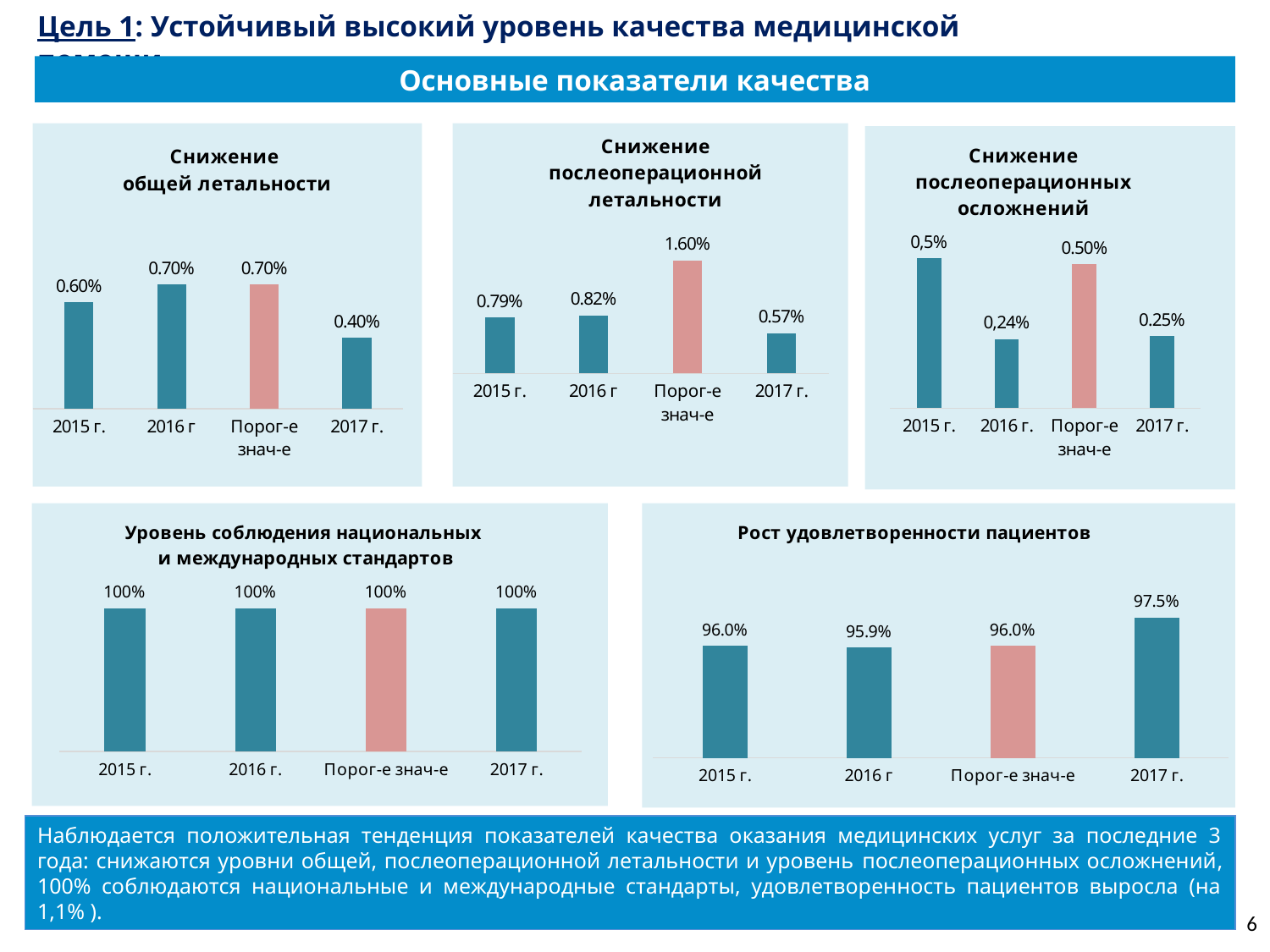
In the chart titled "Снижение послеоперационной летальности", what is the difference between the Порог-е знач-е value and the 2017 г. value? 1.03% In the chart titled "Снижение послеоперационных осложнений", which category has the lowest value? 2016 г. In the chart titled "Рост удовлетворенности пациентов", what is the difference between the 2017 г. value and the 2015 г. value? 1.5% In the chart titled "Снижение послеоперационных осложнений", what is the value for 2016 г.? 0,24% In the chart titled "Рост удовлетворенности пациентов", which category has the highest value? 2017 г. In the chart titled "Уровень соблюдения национальных и международных стандартов", how many bars are plotted? 4 What type of chart is the one titled "Рост удовлетворенности пациентов"? Bar chart In the chart titled "Снижение послеоперационной летальности", which category has the highest value? Порог-е знач-е In the chart titled "Снижение общей летальности", what is the value for 2015 г.? 0.60% In the chart titled "Снижение общей летальности", what is the value for 2017 г.? 0.40% In the chart titled "Уровень соблюдения национальных и международных стандартов", what is the value for 2017 г.? 100% In the chart titled "Снижение послеоперационной летальности", what is the value for 2016 г? 0.82%